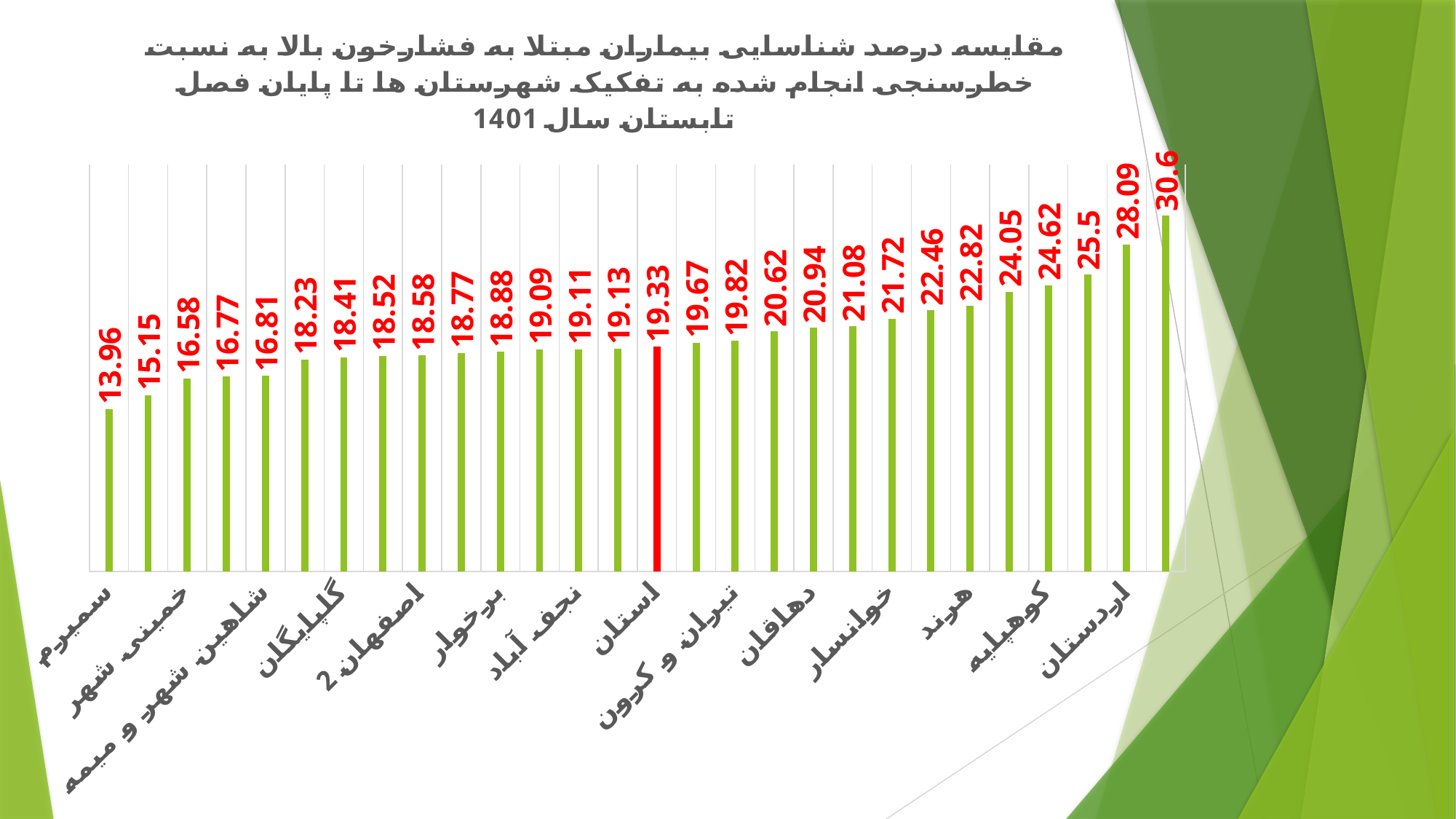
What is the value of the red bar labelled استان? 19.33 Do the values rise or fall moving from left to right along the x axis? rise What is the difference between the values for اردستان and استان? 8.76 What is the value of the bar for اردستان? 28.09 What is the highest value shown in the chart? 30.6 Which category has the lowest value in the chart? سمیرم What kind of chart is shown on the slide? bar chart Which has a larger value, کوهپایه or دهاقان? کوهپایه What is the value of the bar for خوانسار? 21.72 How many bars are plotted in the chart? 28 Which category's bar is coloured red instead of green? استان What is the value of the bar for سمیرم? 13.96